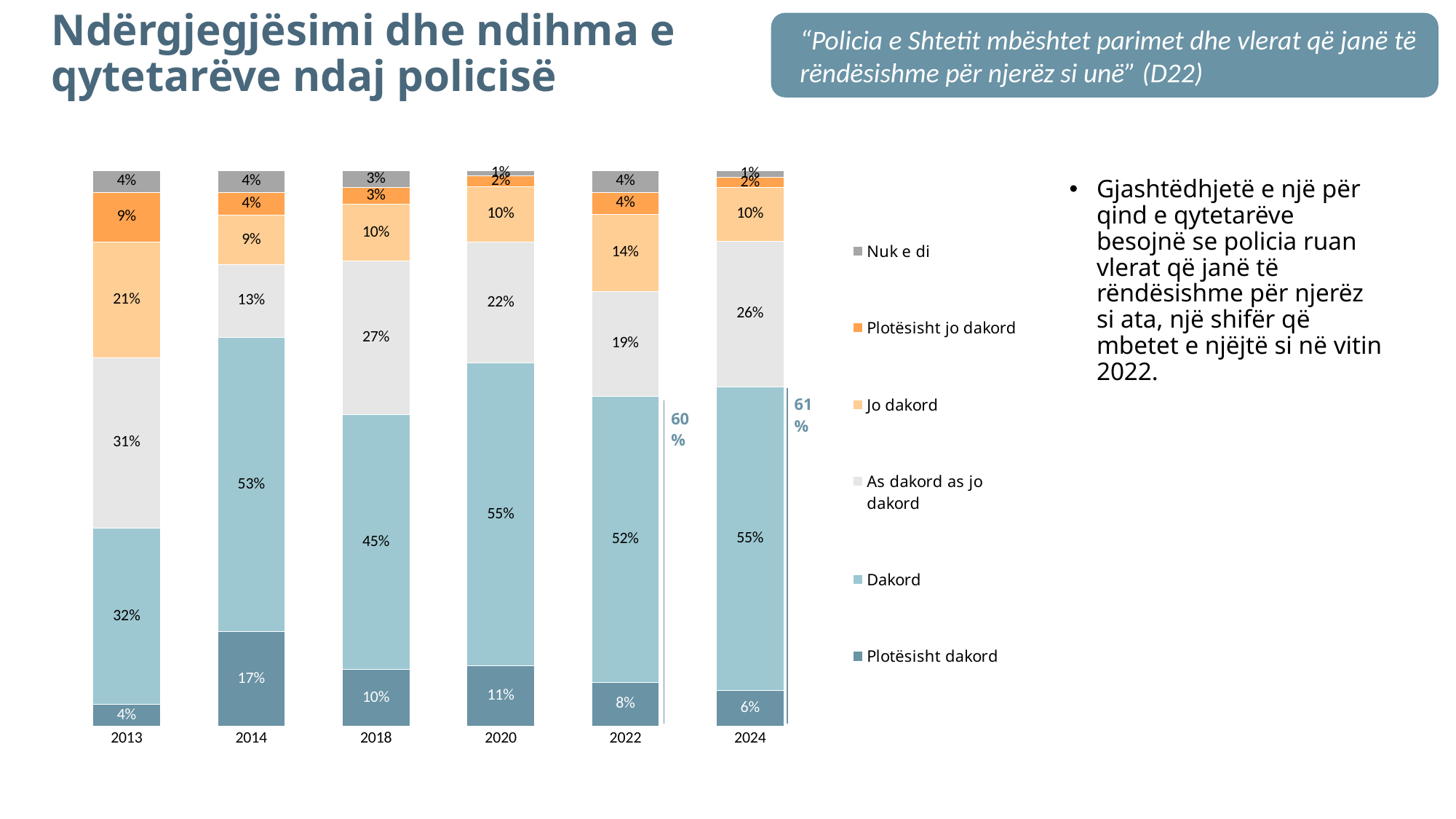
In which year is the 'Plotësisht dakord' value highest? 2014 What is the value for 'As dakord as jo dakord' in 2018? 27% Which is larger: the 'Jo dakord' value in 2022 or in 2024? 2022 What is the value for 'Dakord' in 2014? 53% What is the combined value of 'Plotësisht dakord' and 'Dakord' in 2022, as annotated on the chart? 60% What kind of chart is shown on the slide? Stacked bar chart What is the difference between the 'As dakord as jo dakord' values in 2013 and 2014? 18% How many years (categories) are shown on the x axis of the chart? 6 What is the value for 'Plotësisht dakord' in 2024? 6% How many series does the chart legend list? 6 In which year is the 'Dakord' value lowest? 2013 What is the value for 'Jo dakord' in 2013? 21%